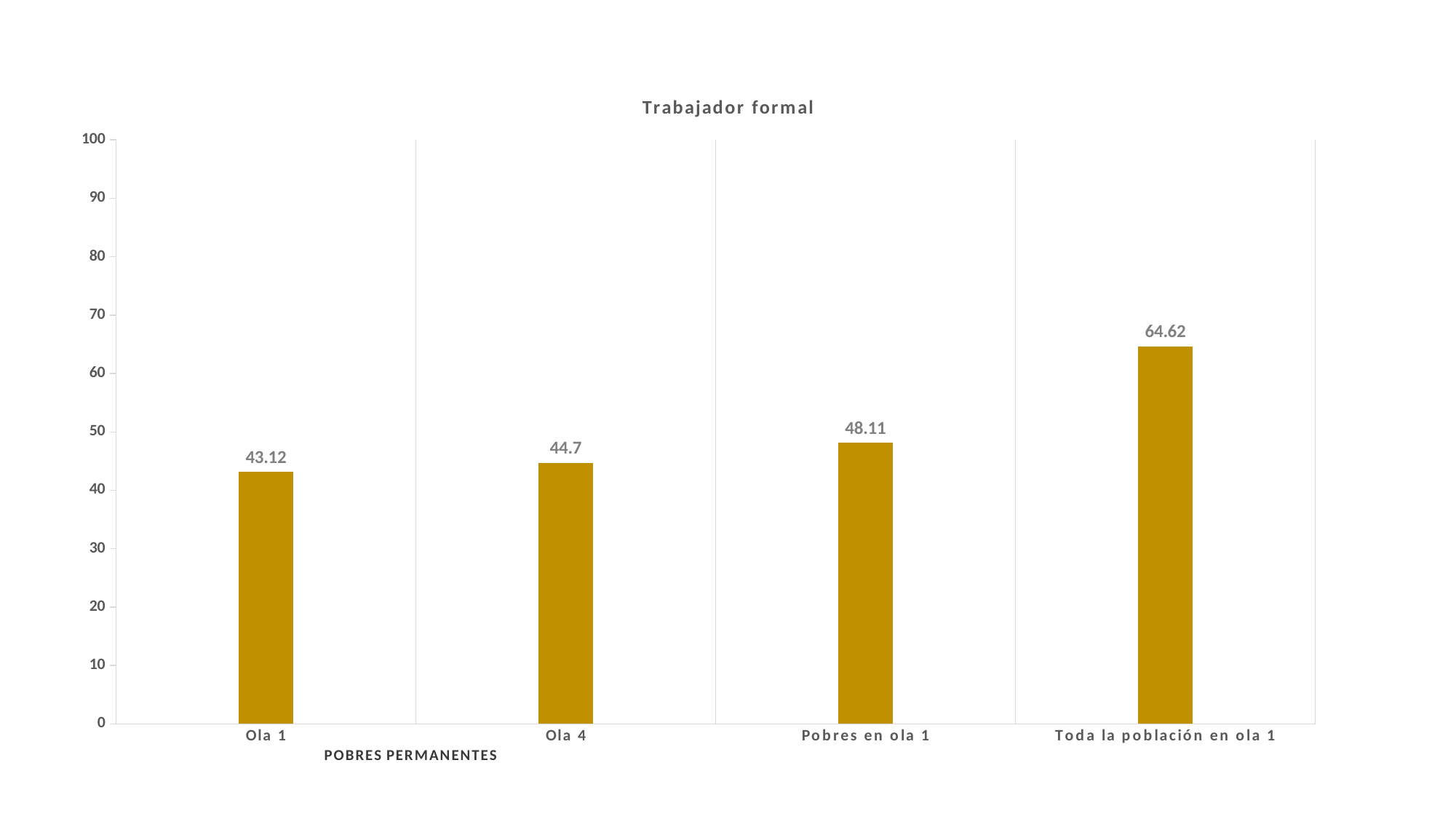
Is the value for Toda la población en ola 1 greater or less than 60? greater What is the difference between the values for Toda la población en ola 1 and Pobres en ola 1? 16.51 What is the value for Ola 1 in the Trabajador formal chart? 43.12 Which category has the lowest value? Ola 1 What is the value for Toda la población en ola 1? 64.62 What is the value for Ola 4? 44.7 What is the difference between the values for Ola 4 and Ola 1? 1.58 What kind of chart is shown on the slide? Bar chart Which category has the highest value? Toda la población en ola 1 Which is larger, the value for Pobres en ola 1 or the value for Ola 4? Pobres en ola 1 What is the value for Pobres en ola 1? 48.11 How many bars are shown in the chart? 4